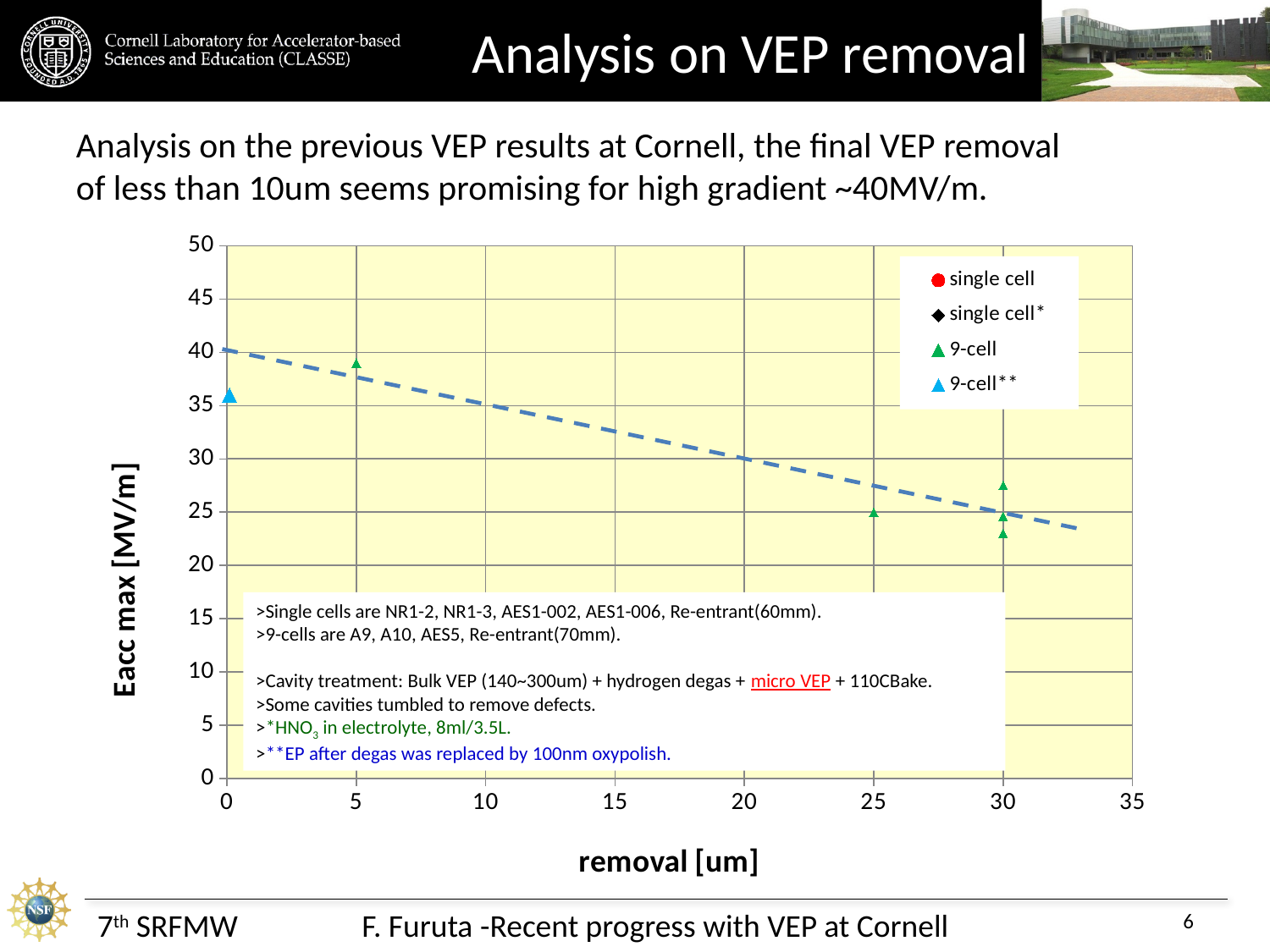
What is the label of the x axis? removal [um] Is the Eacc max value for the 9-cell point at removal 5 um greater or less than 35? greater What are the four series named in the legend? single cell, single cell*, 9-cell, 9-cell** Is the Eacc max value for the 9-cell** point at removal 0 um greater or less than 40? less How many series does the legend list? 4 How many 9-cell data points are plotted at removal 30 um? 3 Is the Eacc max value for the 9-cell** point at removal 0 um greater or less than 30? greater Does the dashed trend line rise or fall as removal increases? fall Which series has the most data points visible on the chart? 9-cell Which has the higher Eacc max: the 9-cell point at removal 5 um or the 9-cell point at removal 25 um? the 9-cell point at removal 5 um What kind of chart is shown on the slide? scatter chart